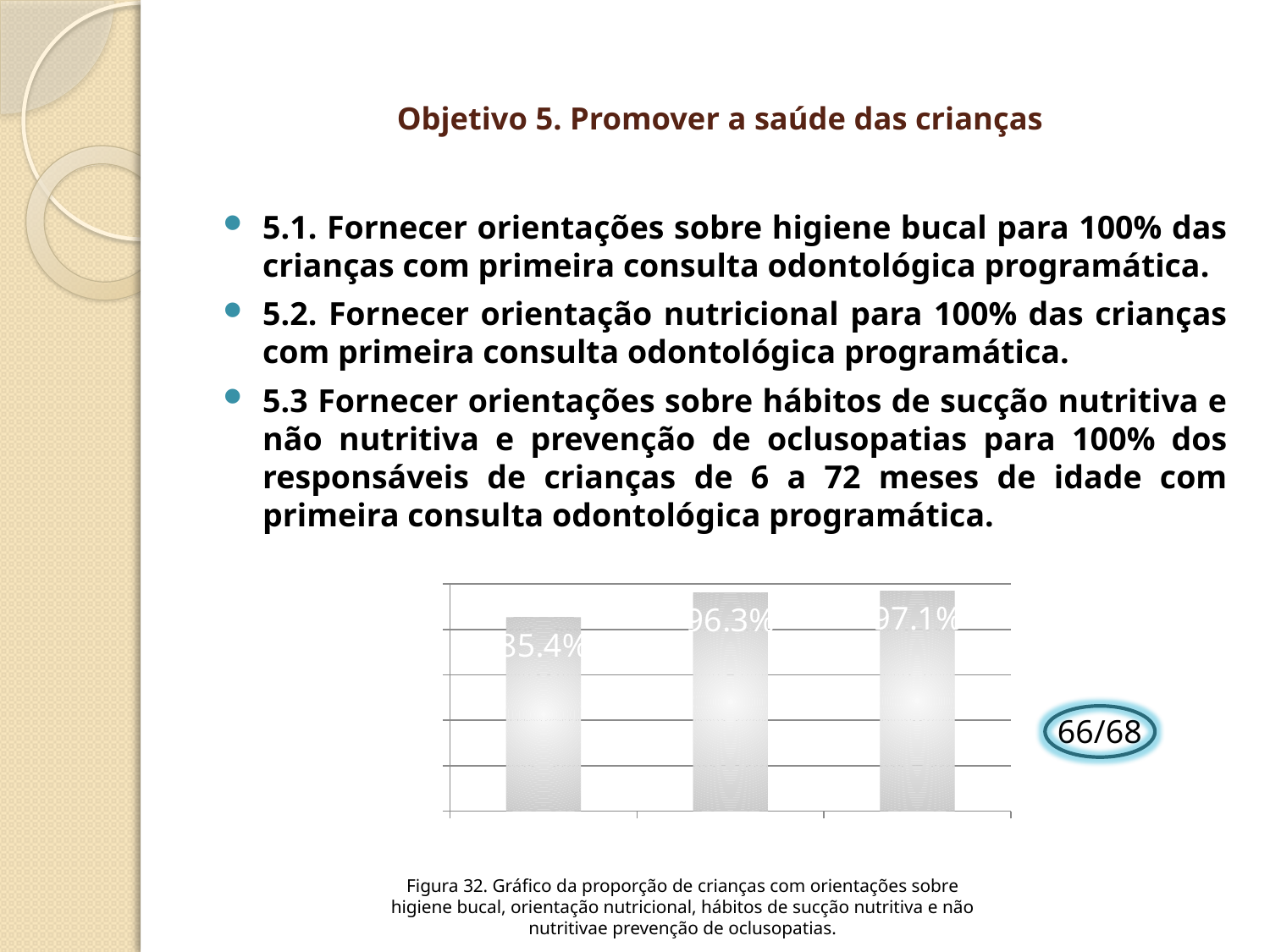
Do the values rise or fall from left to right across the bars? Rise What is the value shown on the first (leftmost) bar of the chart? 85.4% How many bars are plotted in the chart? 3 Which is larger, the value of the first bar or the value of the second bar? The second bar (96.3%) What is the difference between the values of the third bar and the first bar? 11.7% What figure number is given in the caption below the chart? Figura 32 What is the value shown on the third (rightmost) bar of the chart? 97.1% What is the value shown on the middle bar of the chart? 96.3% Which bar has the lowest value in the chart? The first (leftmost) bar, 85.4% What type of chart is shown on the slide? Bar chart Which bar has the highest value in the chart? The third (rightmost) bar, 97.1% What is the difference between the values of the second bar and the first bar? 10.9%